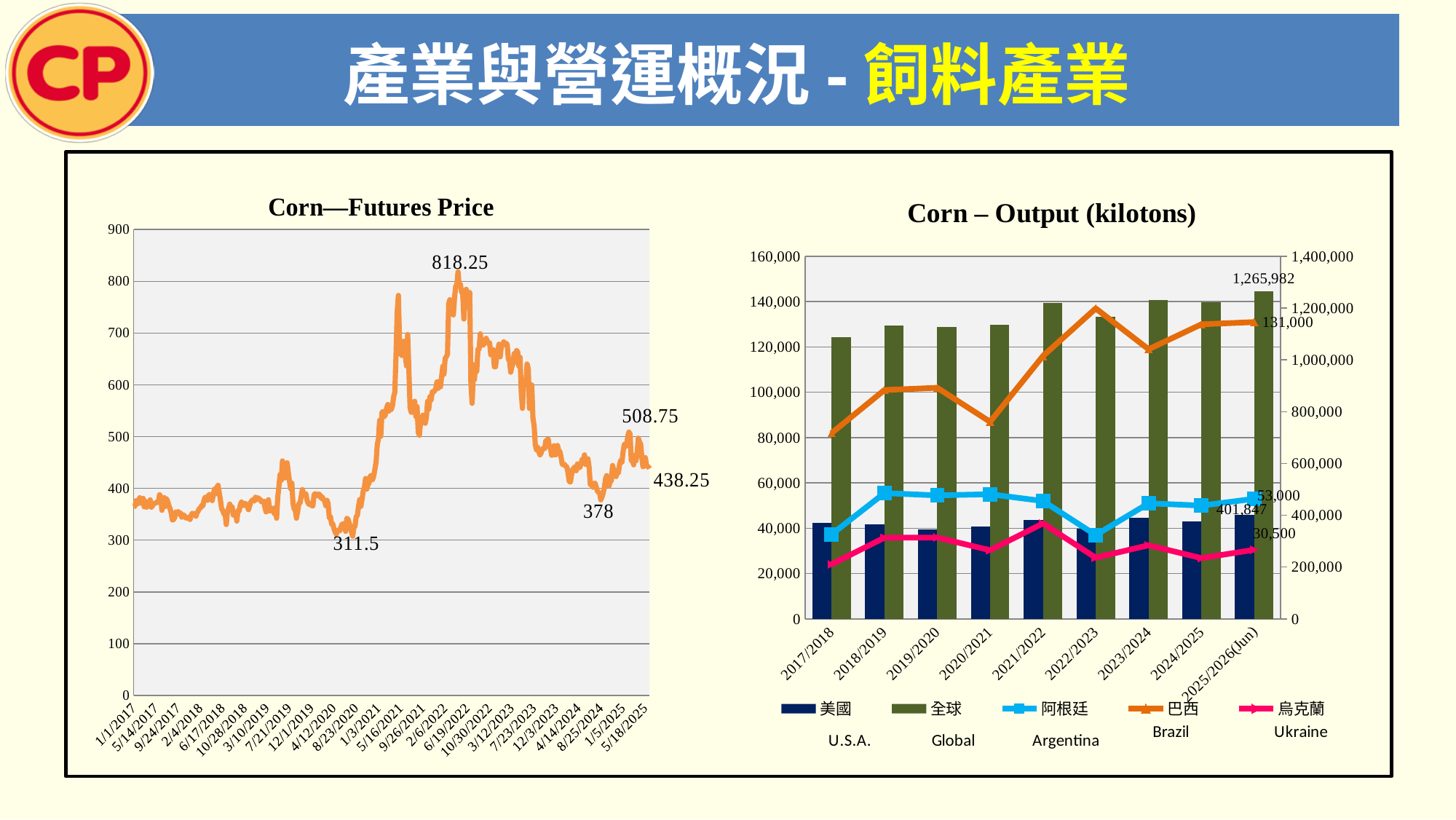
In the Corn – Output (kilotons) chart, what is the Global output for 2025/2026(Jun)? 1,265,982 In the Corn – Output (kilotons) chart, how many series does the legend list? 5 In the Corn – Output (kilotons) chart, is the Brazil value for 2020/2021 greater or less than 100,000 on the left axis? less In the Corn – Output (kilotons) chart, how many crop years are shown on the x axis? 9 In the Corn—Futures Price chart, what is the highest labelled price? 818.25 In the Corn—Futures Price chart, what is the last labelled price at the end of the series? 438.25 What kind of chart is the Corn—Futures Price chart? line chart In the Corn—Futures Price chart, what is the difference between the labelled peak of 818.25 and the labelled low of 311.5? 506.75 In the Corn—Futures Price chart, what is the lowest labelled price? 311.5 In the Corn – Output (kilotons) chart, what is the Brazil output for 2025/2026(Jun)? 131,000 In the Corn – Output (kilotons) chart, which is larger for 2025/2026(Jun): Brazil or Argentina? Brazil In the Corn—Futures Price chart, what is the difference between the labelled values 508.75 and 438.25? 70.5